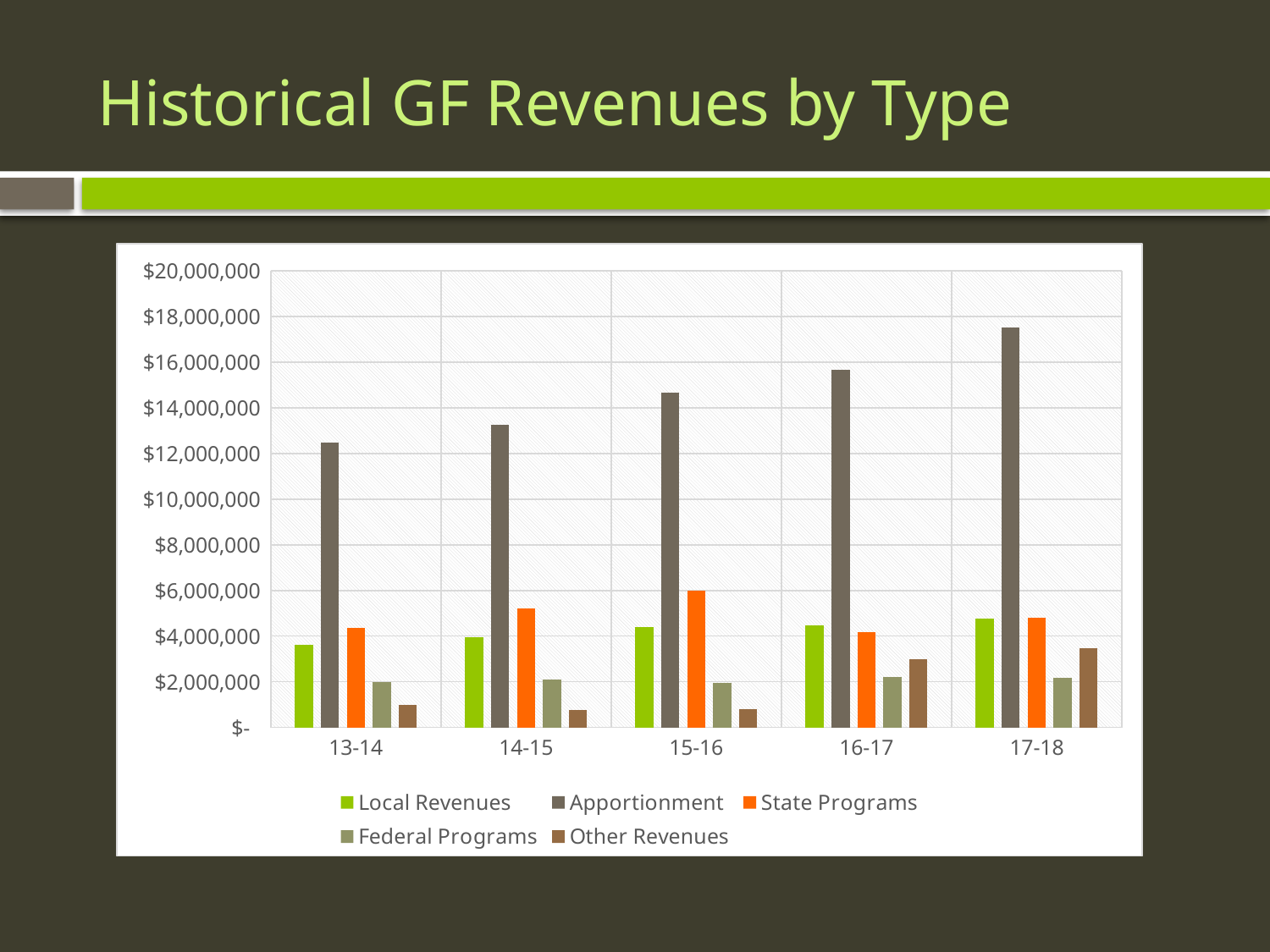
What is the title of the slide containing the chart? Historical GF Revenues by Type How many series does the chart's legend list? 5 Is the Apportionment value for 17-18 greater or less than $16,000,000? greater In which year is the Apportionment bar the highest? 17-18 In 15-16, which is larger: State Programs or Local Revenues? State Programs Which series has the lowest value in 13-14? Other Revenues Is the State Programs value for 15-16 greater or less than $4,000,000? greater How many fiscal years are shown on the x axis of the chart? 5 Does the Apportionment series rise or fall from 13-14 to 17-18? rise Is the Apportionment value for 13-14 greater or less than $14,000,000? less What kind of chart is shown on the slide? bar chart In 16-17, which is larger: Other Revenues or Federal Programs? Other Revenues